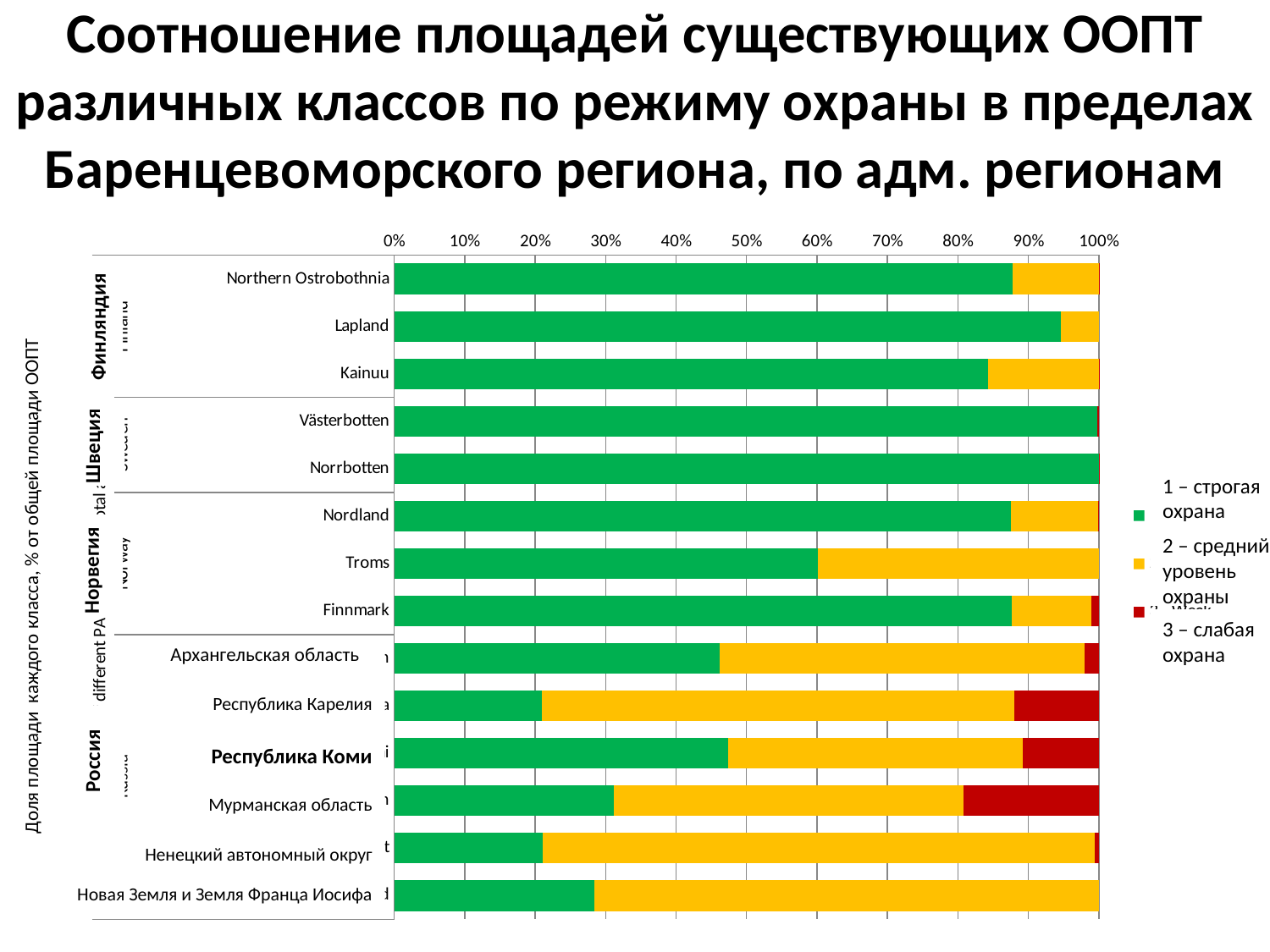
How many administrative regions (bars) are plotted in the chart? 14 Is the green (1 – строгая охрана) share for Архангельская область greater or less than 50%? less Which region has the largest red (3 – слабая охрана) segment? Мурманская область Is the green (1 – строгая охрана) share for Kainuu greater or less than 90%? less Which has the larger green (1 – строгая охрана) share, Nordland or Troms? Nordland Is the green (1 – строгая охрана) share for Troms greater or less than 50%? greater Which has the larger green (1 – строгая охрана) share, Республика Коми or Республика Карелия? Республика Коми Which legend entry is shown in red? 3 – слабая охрана How many series does the legend list? 3 What kind of chart is shown on the slide? stacked bar chart